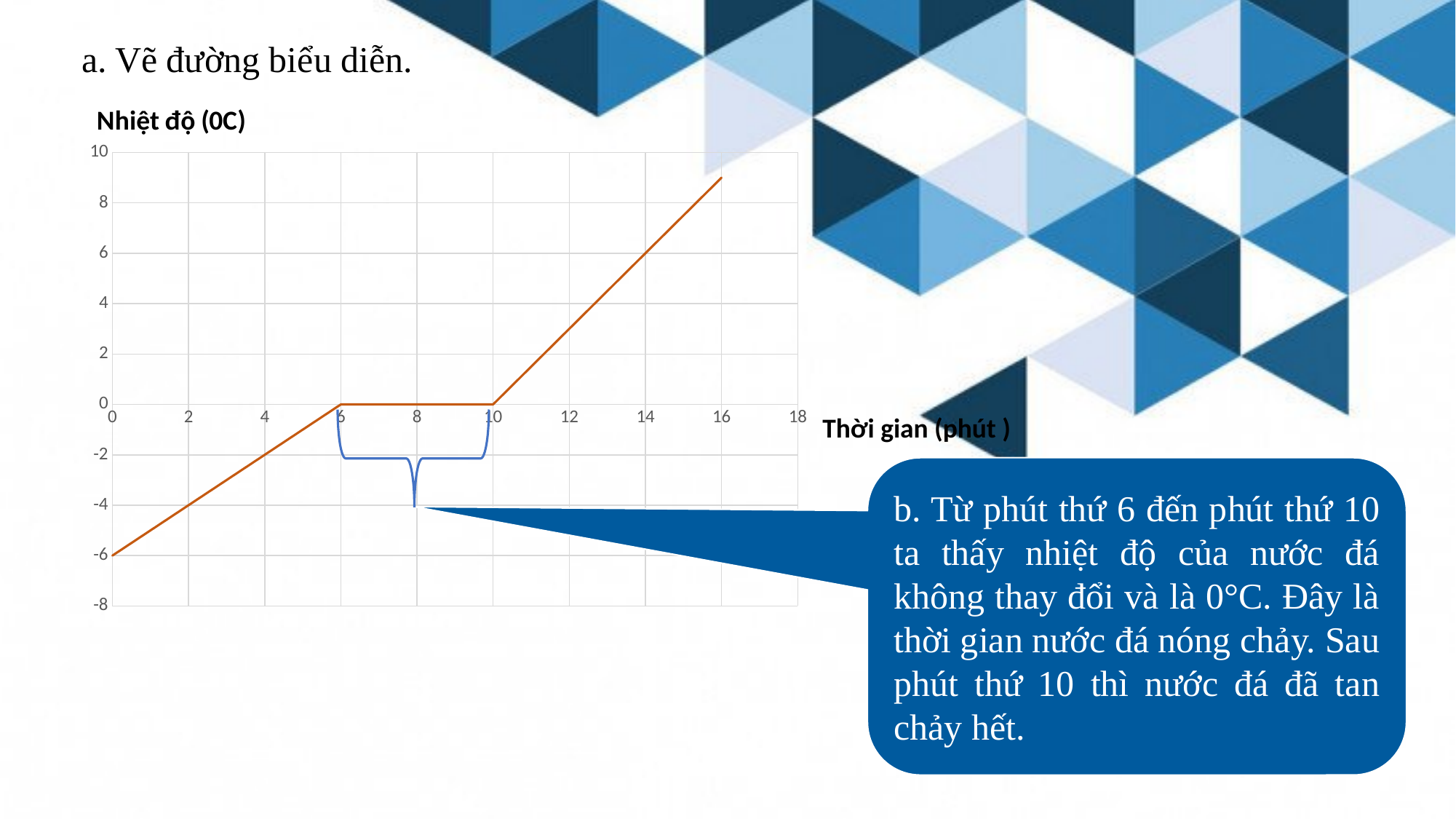
What is the difference between the temperature at minute 6 and at minute 0? 6 What is the temperature at time 0 minutes? -6 How does the temperature change between minute 6 and minute 10? it stays constant at 0 Is the temperature at minute 14 greater or less than 4? greater What is the temperature at minute 6? 0 Is the temperature at minute 16 greater or less than 8? greater At which time is the temperature lowest? 0 minutes What kind of chart is shown on the slide? line chart What is the label of the horizontal axis? Thời gian (phút ) Is the temperature at minute 2 greater or less than -2? less What is the temperature at minute 10? 0